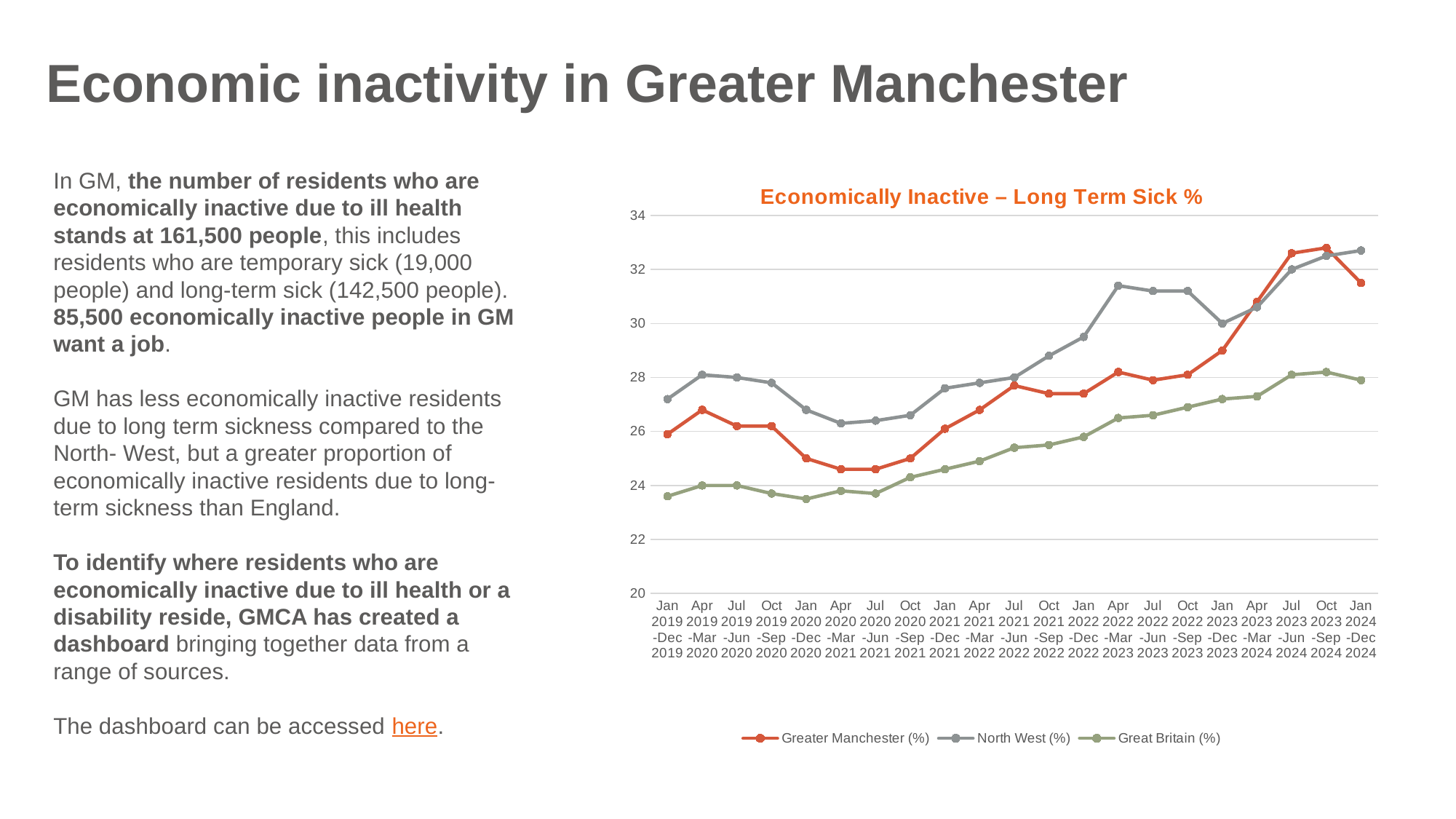
Is the value for Greater Manchester (%) in Apr 2020-Mar 2021 greater or less than 26? less How many series does the legend of the chart list? 3 Overall, does the Great Britain (%) series rise or fall from Jan 2019-Dec 2019 to Jan 2024-Dec 2024? Rise Is the value for North West (%) in Apr 2022-Mar 2023 greater or less than 30? greater Is the value for Greater Manchester (%) in Oct 2023-Sep 2024 greater or less than 32? greater What is the title of the chart? Economically Inactive – Long Term Sick % In Jan 2019-Dec 2019, which is larger: Greater Manchester (%) or Great Britain (%)? Greater Manchester (%) How many time periods are plotted along the x axis of the chart? 21 What kind of chart is shown on the slide? Line chart In Apr 2022-Mar 2023, which is larger: Greater Manchester (%) or North West (%)? North West (%) Which series has the lowest value in Jan 2024-Dec 2024? Great Britain (%)